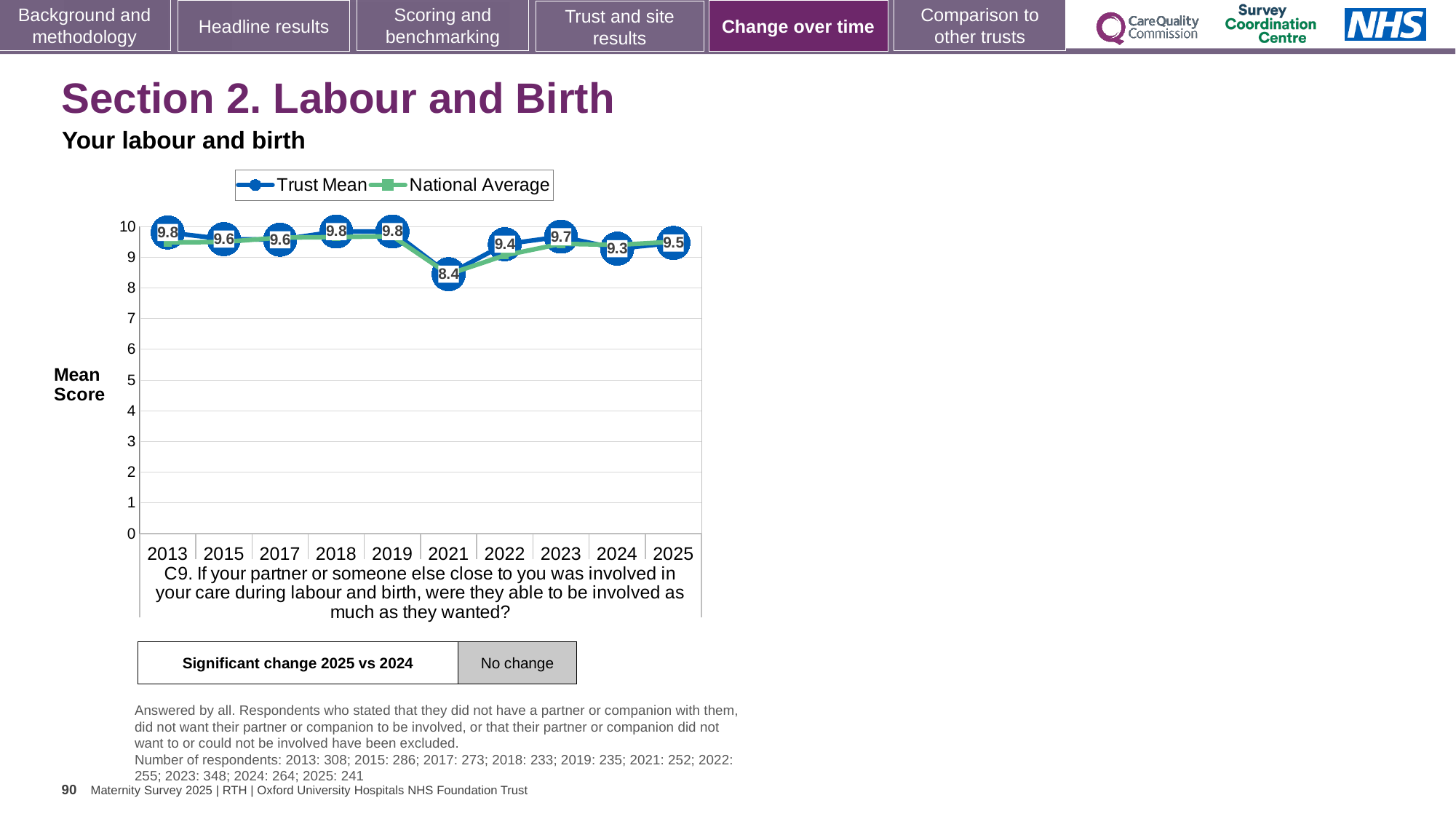
Which year has the higher Trust Mean score, 2022 or 2024? 2022 How many years are shown on the x axis of the chart? 10 What kind of chart is shown on the slide? line chart What is the difference between the Trust Mean scores for 2025 and 2024? 0.2 In which year is the Trust Mean score lowest? 2021 Did the Trust Mean score rise or fall from 2024 to 2025? rise Is the Trust Mean score for 2021 greater or less than 9? less How many series does the chart legend list? 2 What is the Trust Mean score for 2025? 9.5 What is the Trust Mean score for 2021? 8.4 What is the Trust Mean score for 2023? 9.7 What is the difference between the Trust Mean scores for 2019 and 2021? 1.4